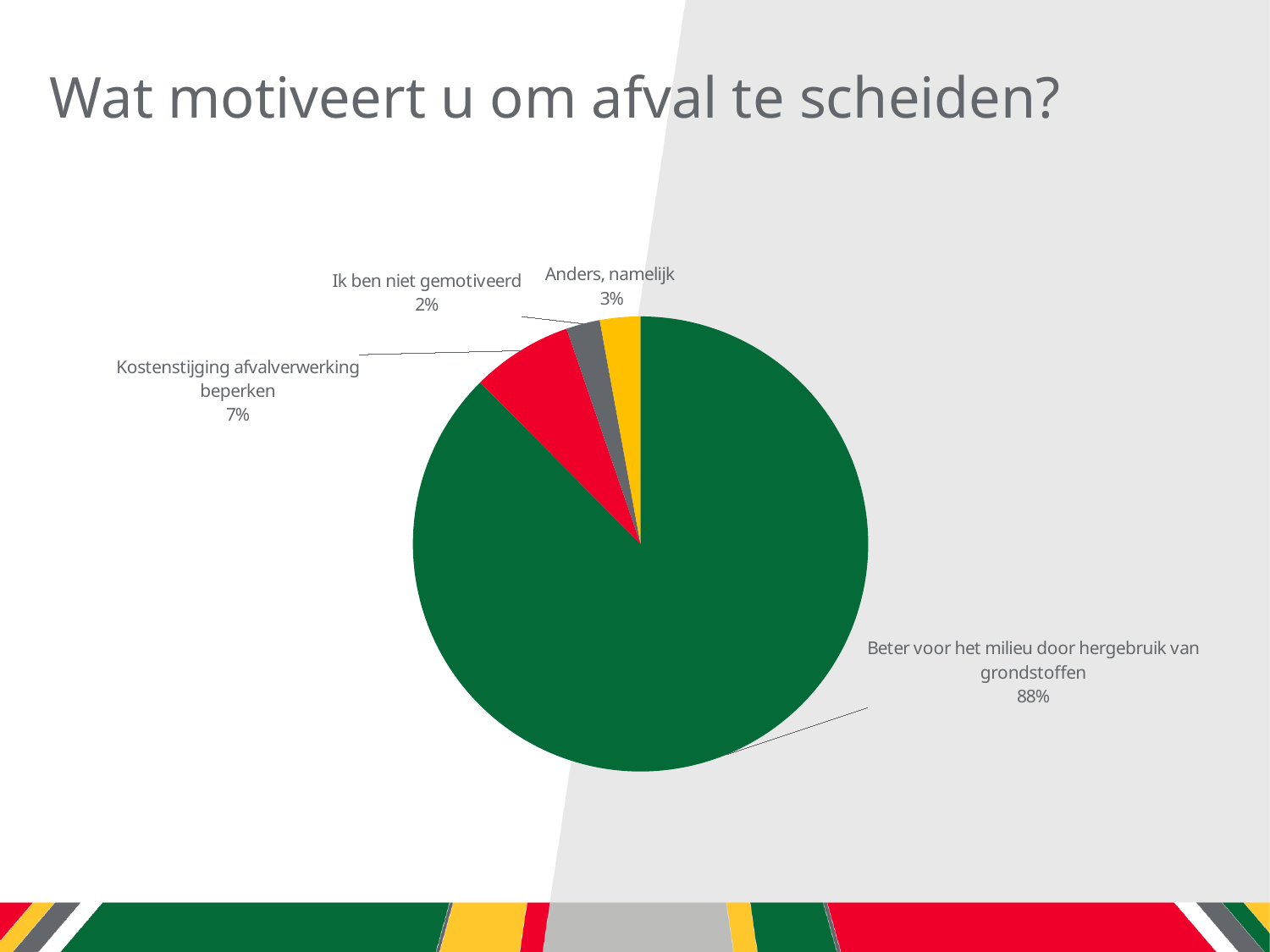
What kind of chart is shown on the slide? pie chart What colour is the slice for 'Kostenstijging afvalverwerking beperken'? red What share of the pie is 'Anders, namelijk'? 3% Which category has the largest slice of the pie? Beter voor het milieu door hergebruik van grondstoffen Which category has the smallest slice of the pie? Ik ben niet gemotiveerd What is the title of the slide? Wat motiveert u om afval te scheiden? What share of the pie is 'Ik ben niet gemotiveerd'? 2% How many slices does the pie chart have? 4 What is the difference in percentage points between 'Kostenstijging afvalverwerking beperken' and 'Anders, namelijk'? 4% Which is larger: 'Anders, namelijk' or 'Ik ben niet gemotiveerd'? Anders, namelijk What share of the pie is 'Kostenstijging afvalverwerking beperken'? 7%